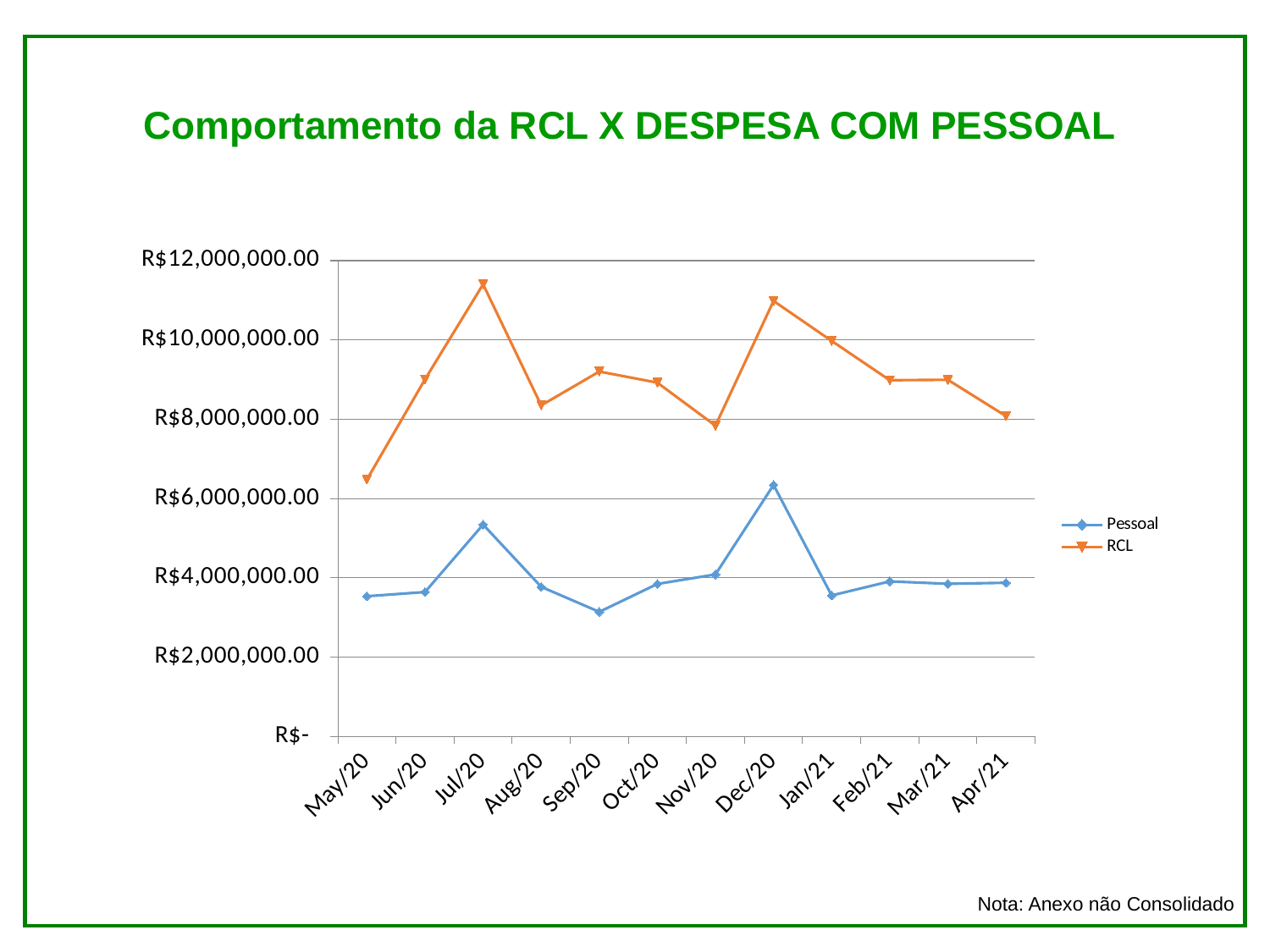
How many series does the legend list? 2 Is the RCL value for Jul/20 greater or less than R$10,000,000.00? greater Is the Pessoal value for Dec/20 greater or less than R$6,000,000.00? greater In which month does the RCL series reach its highest value? Jul/20 Which series has the larger value in Dec/20, Pessoal or RCL? RCL What kind of chart is shown on the slide? line chart Does the RCL series rise or fall from Dec/20 to Apr/21? fall In which month is the RCL series at its lowest value? May/20 Is the RCL value for May/20 greater or less than R$8,000,000.00? less In which month is the Pessoal series at its lowest value? Sep/20 How many months are plotted along the x axis? 12 In which month does the Pessoal series reach its highest value? Dec/20